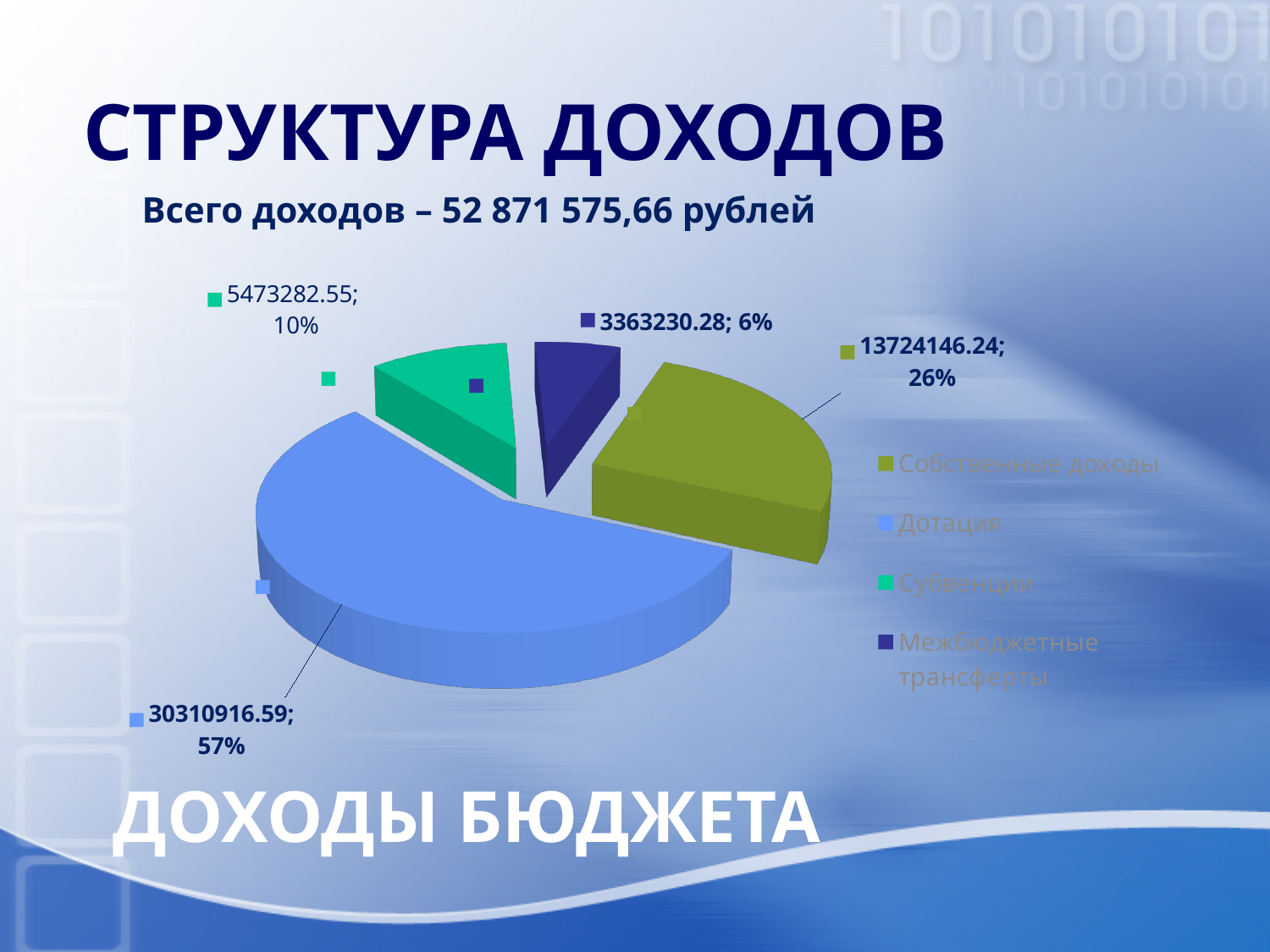
What kind of chart is shown on the slide? pie chart Which category has the smallest slice of the pie? Межбюджетные трансферты Which category has the largest slice of the pie? Дотация What percentage share does the Межбюджетные трансферты slice have? 6% What value is shown for the Субвенции slice? 5473282.55 What is the difference in percentage points between the Дотация share and the Собственные доходы share? 31 How many slices does the pie chart have? 4 What percentage share does the Субвенции slice have? 10% What value is shown for the Дотация slice? 30310916.59 What percentage share does the Собственные доходы slice have? 26% Which is larger, the Собственные доходы slice or the Субвенции slice? Собственные доходы What total income amount is stated above the chart? 52 871 575,66 рублей